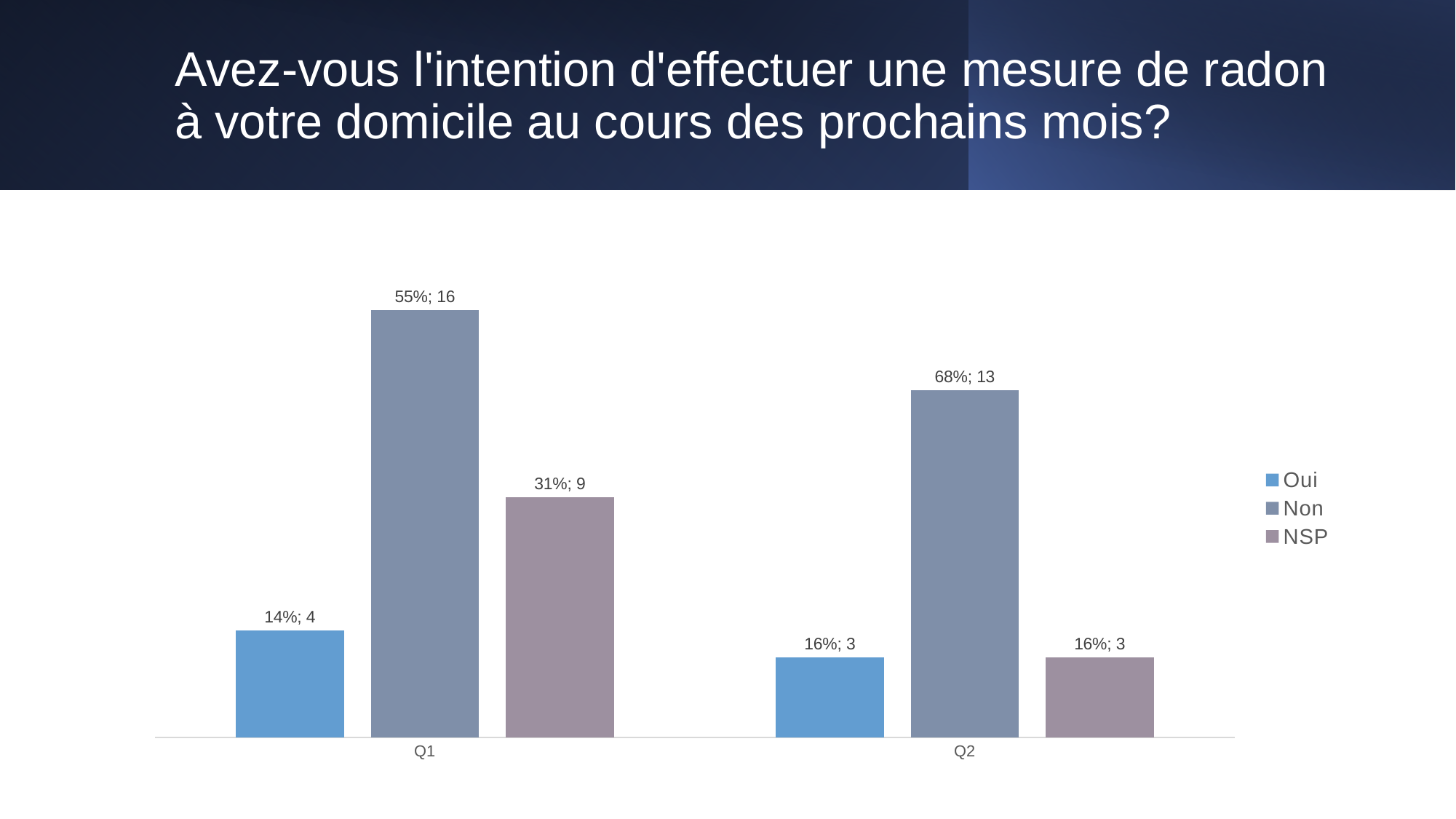
How many series does the legend list? 3 What is the data label on the Oui bar for Q2? 16%; 3 Which series has the lowest bar in Q1? Oui What is the data label on the Non bar for Q1? 55%; 16 What is the difference in count between Non and NSP in Q1? 7 What kind of chart is shown on the slide? Bar chart What percentage is shown for Non in Q2? 68% How many categories are shown on the x axis? 2 Which is larger, the NSP bar in Q1 or the NSP bar in Q2? NSP in Q1 Which series has the highest bar in Q1? Non What is the difference in percentage between Non in Q2 and Non in Q1? 13% What is the data label on the NSP bar for Q1? 31%; 9